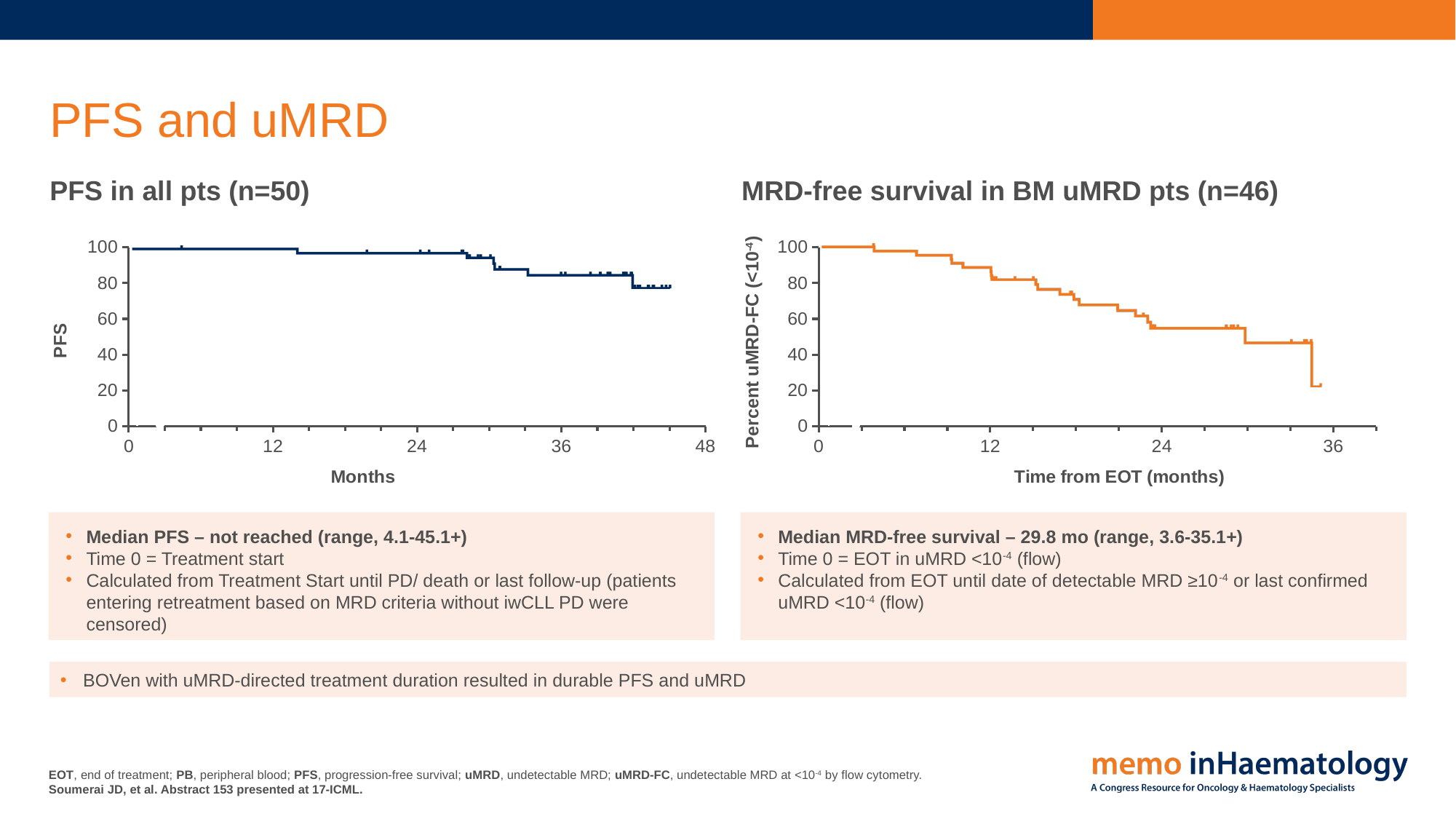
In the 'MRD-free survival in BM uMRD pts (n=46)' chart, is the value at 12 months from EOT greater or less than 60? greater In the 'PFS in all pts (n=50)' chart, is the PFS value at 24 months greater or less than 80? greater In the 'PFS in all pts (n=50)' chart, is the PFS value at 12 months greater or less than 80? greater What kind of chart is the 'PFS in all pts (n=50)' chart? line chart What is the x-axis label of the 'MRD-free survival in BM uMRD pts (n=46)' chart? Time from EOT (months) In the 'MRD-free survival in BM uMRD pts (n=46)' chart, does the curve rise or fall over time from EOT? fall What colour is the curve in the 'MRD-free survival in BM uMRD pts (n=46)' chart? orange In the 'PFS in all pts (n=50)' chart, does the PFS curve rise or fall as months increase? fall At 24 months, which chart shows the higher curve value: 'PFS in all pts (n=50)' or 'MRD-free survival in BM uMRD pts (n=46)'? PFS in all pts (n=50)